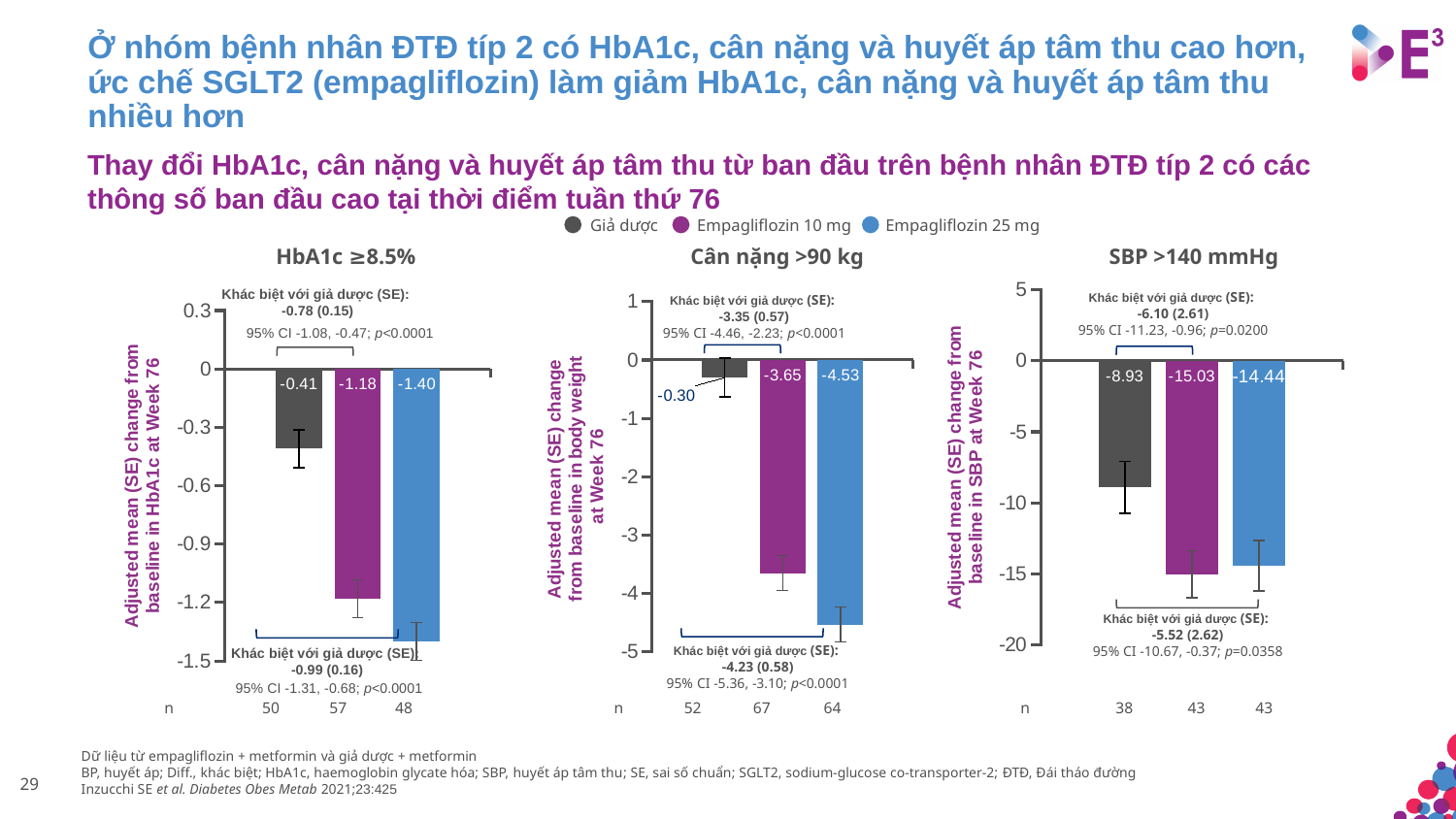
How many series does the legend list? 3 In the Cân nặng >90 kg chart, which group has the smallest change in body weight? Giả dược In the Cân nặng >90 kg chart, what is the adjusted mean change in body weight for Giả dược? -0.30 In the Cân nặng >90 kg chart, what is the n for the Empagliflozin 10 mg group? 67 In the SBP >140 mmHg chart, what is the adjusted mean change in SBP for Empagliflozin 10 mg? -15.03 In the SBP >140 mmHg chart, which group has the largest reduction in SBP? Empagliflozin 10 mg How many bars are shown in the SBP >140 mmHg chart? 3 What type of chart is used for the HbA1c ≥8.5% panel? Bar chart In the HbA1c ≥8.5% chart, what is the difference between the Empagliflozin 10 mg value (-1.18) and the Giả dược value (-0.41)? -0.77 Which colour represents Empagliflozin 25 mg in the legend? Blue In the HbA1c ≥8.5% chart, what is the adjusted mean change from baseline for Empagliflozin 25 mg? -1.40 In the Cân nặng >90 kg chart, is the reduction in body weight larger for Empagliflozin 25 mg or Empagliflozin 10 mg? Empagliflozin 25 mg